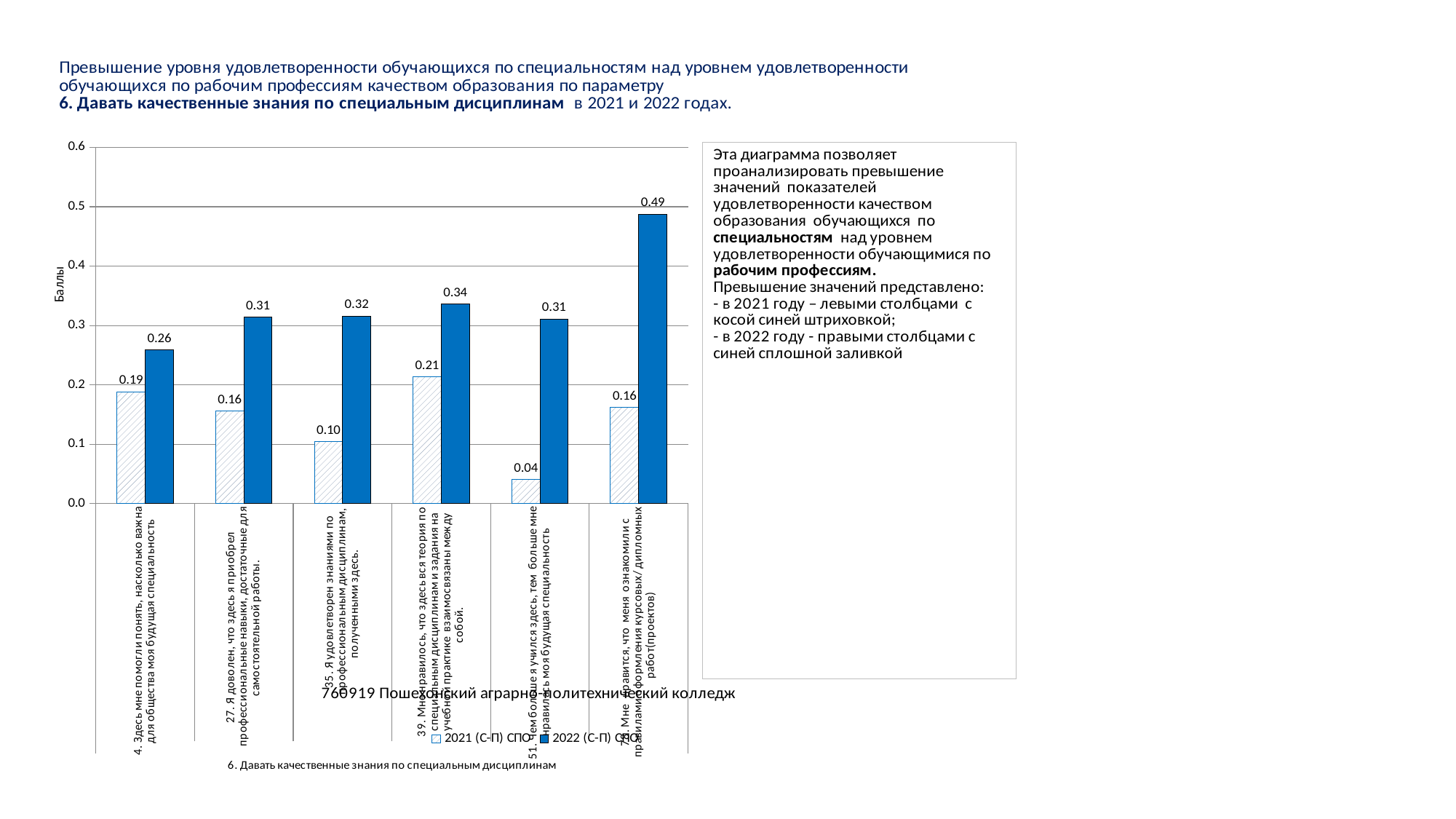
Which is larger: the 2022 (С-П) СПО value for statement 4 or for statement 39? Statement 39 (0.34) What is the title of the vertical axis of the chart? Баллы What is the 2021 (С-П) СПО value for statement 39 ("Мне нравилось, что здесь вся теория по специальным дисциплинам и задания на учебной практике взаимосвязаны между собой")? 0.21 How many categories (statements) are plotted along the x axis of the chart? 6 What kind of chart is shown on the slide? bar chart Which statement has the highest 2022 (С-П) СПО value, and what is it? Statement 78 (about оформление курсовых/дипломных работ), 0.49 Is the 2022 (С-П) СПО value for the rightmost statement (70) greater or less than 0.4? greater What is the 2022 (С-П) СПО value for statement 4 ("Здесь мне помогли понять, насколько важна для общества моя будущая специальность")? 0.26 For statement 35 ("Я удовлетворен знаниями по профессиональным дисциплинам, полученными здесь"), what is the difference between the 2022 and 2021 values? 0.22 How many series does the chart legend list? 2 What is the 2021 (С-П) СПО value for statement 51 ("Чем больше я учился здесь, тем больше мне нравилась моя будущая специальность")? 0.04 Which statement has the lowest 2021 (С-П) СПО value? Statement 51, 0.04